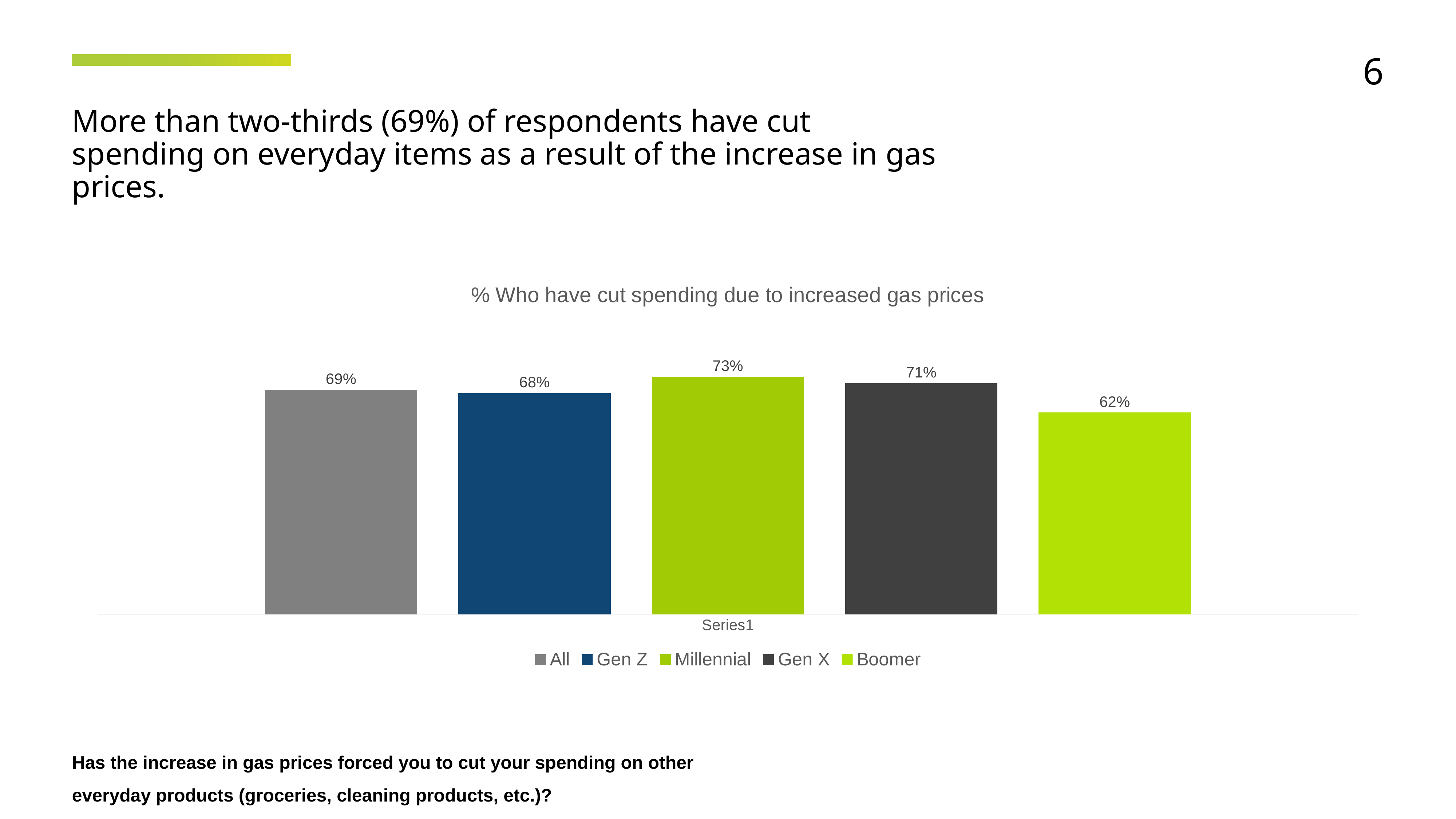
What is the title of the chart? % Who have cut spending due to increased gas prices What is the difference in percentage points between Gen X and Gen Z? 3 What is the value shown for Gen X in the chart? 71% What is the value shown for Gen Z in the chart? 68% What percentage of Millennial respondents have cut spending due to increased gas prices? 73% How many series does the legend list? 5 Which is larger, the value for Gen X or the value for Boomer? Gen X What is the value shown for Boomer in the chart? 62% What is the difference in percentage points between Millennial and Boomer? 11 What kind of chart is shown on the slide? Bar chart Which group has the lowest percentage who have cut spending due to increased gas prices? Boomer Which group has the highest percentage who have cut spending due to increased gas prices? Millennial